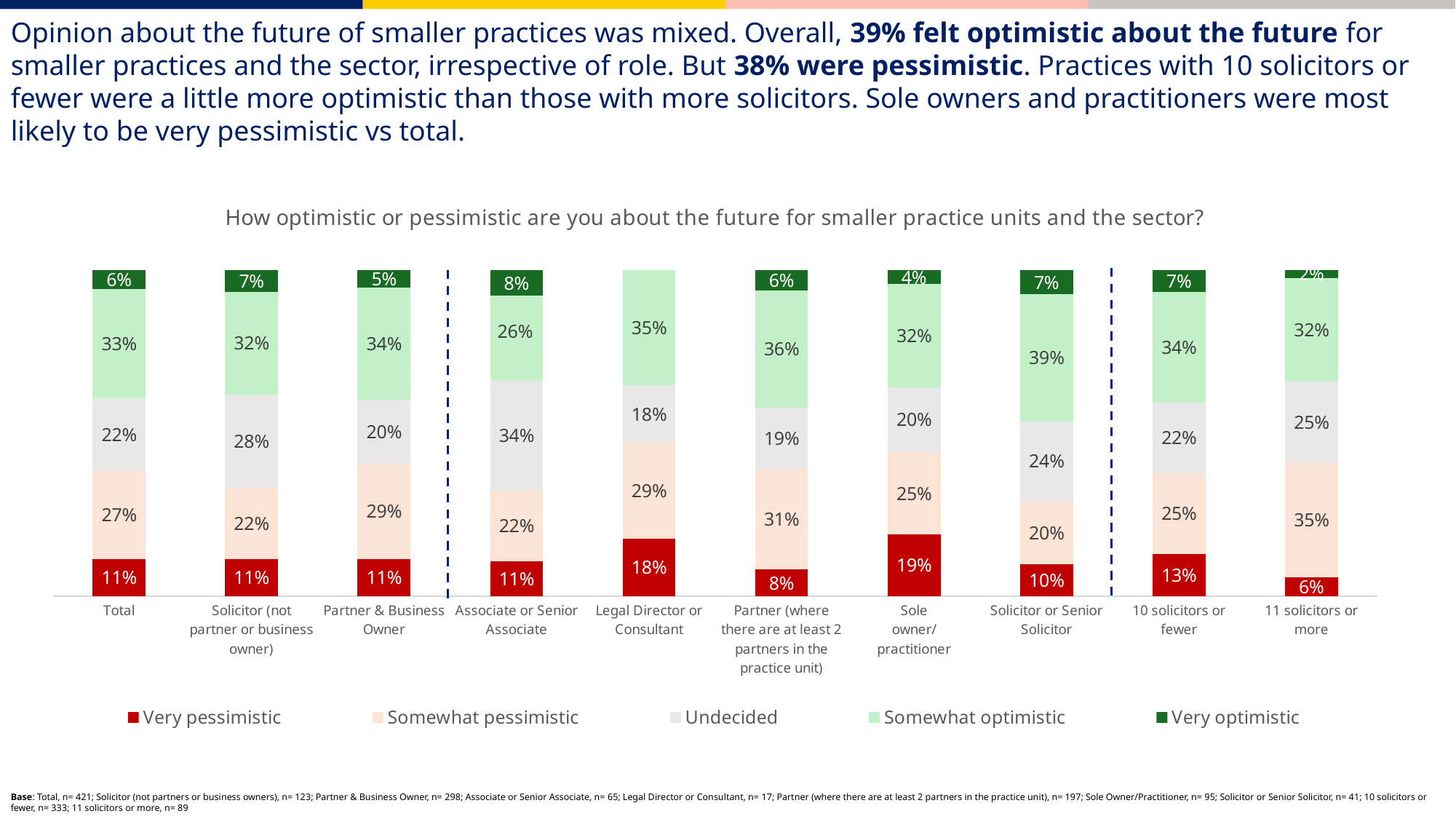
How many categories are shown on the x axis of the chart? 10 How many series does the legend list? 5 Which category has the highest Very pessimistic share? Sole owner/practitioner Which category has the highest Somewhat optimistic share? Solicitor or Senior Solicitor What kind of chart is shown on the slide? Stacked bar chart What is the difference in the Very pessimistic share between Sole owner/practitioner and Total? 8% What percentage of Legal Director or Consultant respondents were Undecided? 18% What percentage of the Total group were Very pessimistic? 11% What percentage of respondents from practices with 11 solicitors or more were Somewhat pessimistic? 35% Which category has the lowest Very pessimistic share? 11 solicitors or more Which has a larger Undecided share: Associate or Senior Associate, or Partner & Business Owner? Associate or Senior Associate What percentage of Sole owner/practitioner respondents were Somewhat optimistic? 32%